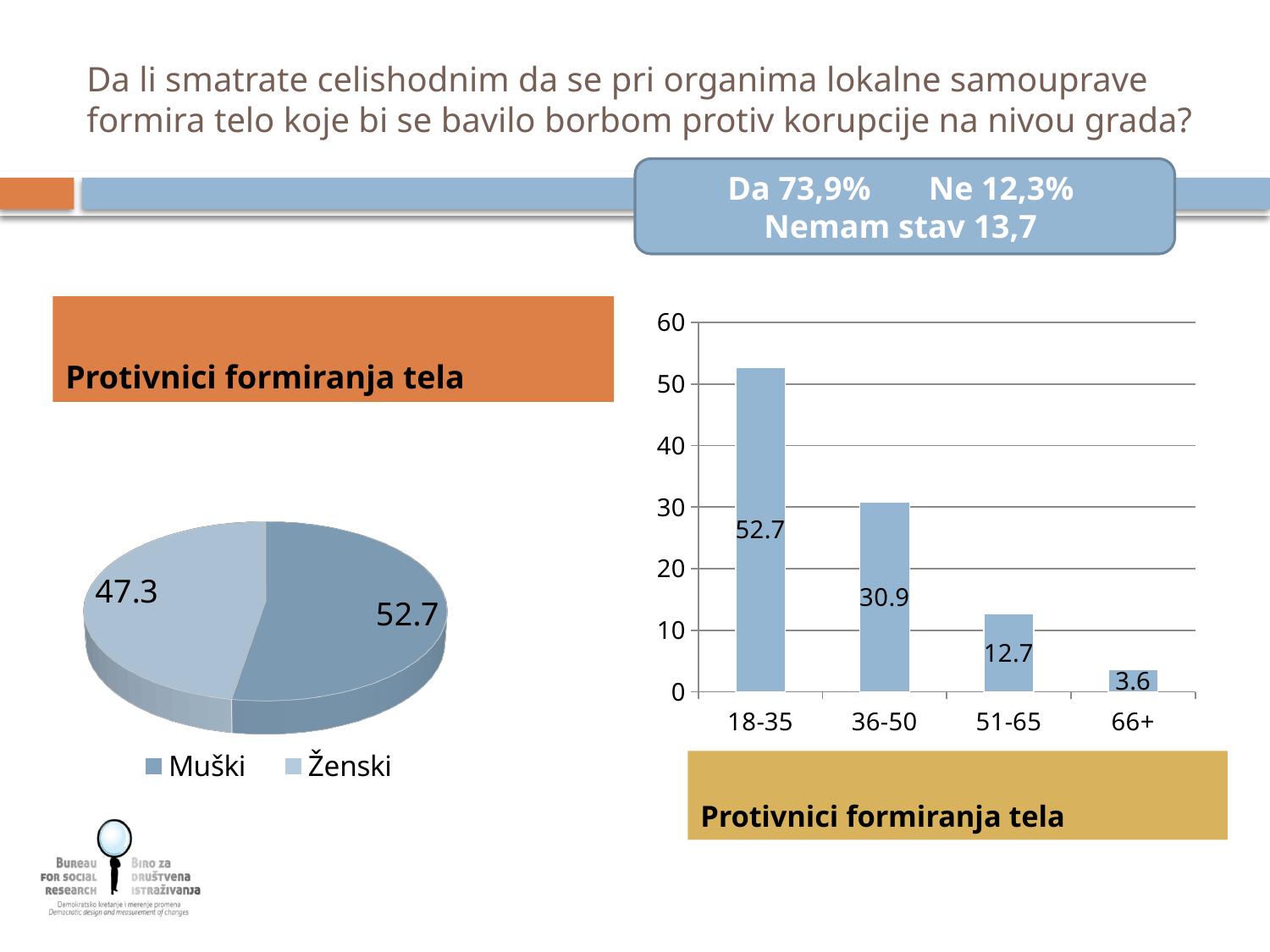
In the pie chart on the left, what is the value for Muški? 52.7 In the bar chart on the right, which age group has the highest value? 18-35 In the bar chart on the right, is the value for 36-50 greater or less than 40? less In the bar chart on the right, do the values rise or fall from 18-35 to 66+? fall In the pie chart on the left, how many entries does the legend list? 2 In the pie chart on the left, which is larger, Muški or Ženski? Muški In the bar chart on the right, what is the value for the 66+ age group? 3.6 In the bar chart on the right, how many age groups are shown? 4 In the bar chart on the right, what is the value for the 18-35 age group? 52.7 In the bar chart on the right, which age group has the lowest value? 66+ What kind of chart is shown on the left side of the slide? pie chart In the bar chart on the right, what is the difference between the values for 36-50 and 51-65? 18.2